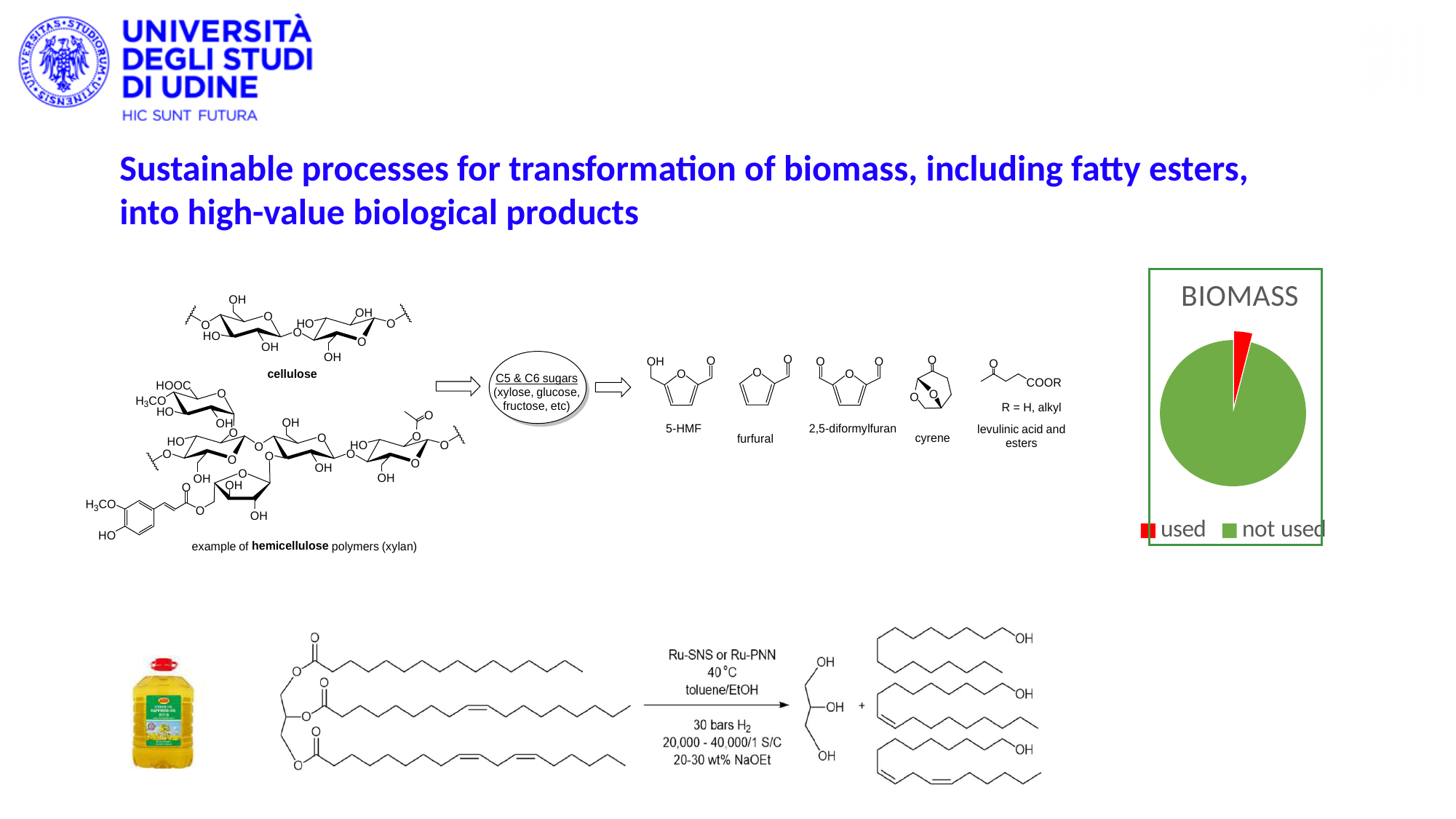
Which category takes the smallest slice of the BIOMASS pie chart? used How many categories does the BIOMASS pie chart show? 2 What are the two legend entries of the BIOMASS pie chart? used, not used What is the title of the pie chart on the right of the slide? BIOMASS Which category takes the largest slice of the BIOMASS pie chart? not used In the BIOMASS pie chart, which slice is larger, used or not used? not used What colour is the 'used' slice in the BIOMASS pie chart? red What kind of chart is shown under the title BIOMASS? pie chart